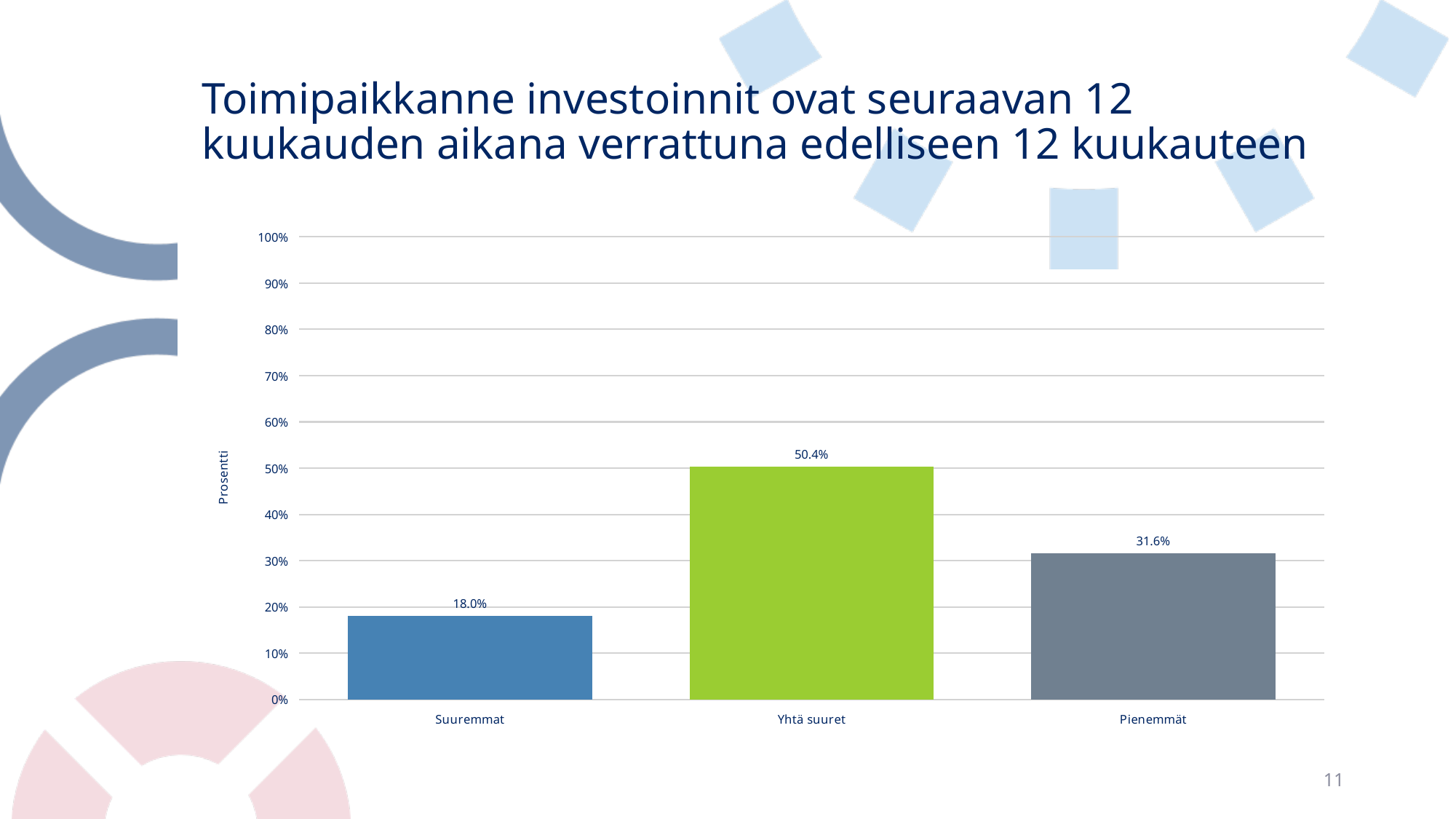
What is the value for Suuremmat? 18.0% How many categories are shown on the x axis? 3 What is the difference between the values for Pienemmät and Suuremmat? 13.6% Is the value for Yhtä suuret greater or less than 50%? greater What is the value for Yhtä suuret? 50.4% What kind of chart is shown on the slide? bar chart Which is larger, the value for Pienemmät or the value for Suuremmat? Pienemmät Which category has the highest value? Yhtä suuret What is the label of the vertical axis? Prosentti What is the value for Pienemmät? 31.6% Which category has the lowest value? Suuremmat What is the difference between the values for Yhtä suuret and Pienemmät? 18.8%